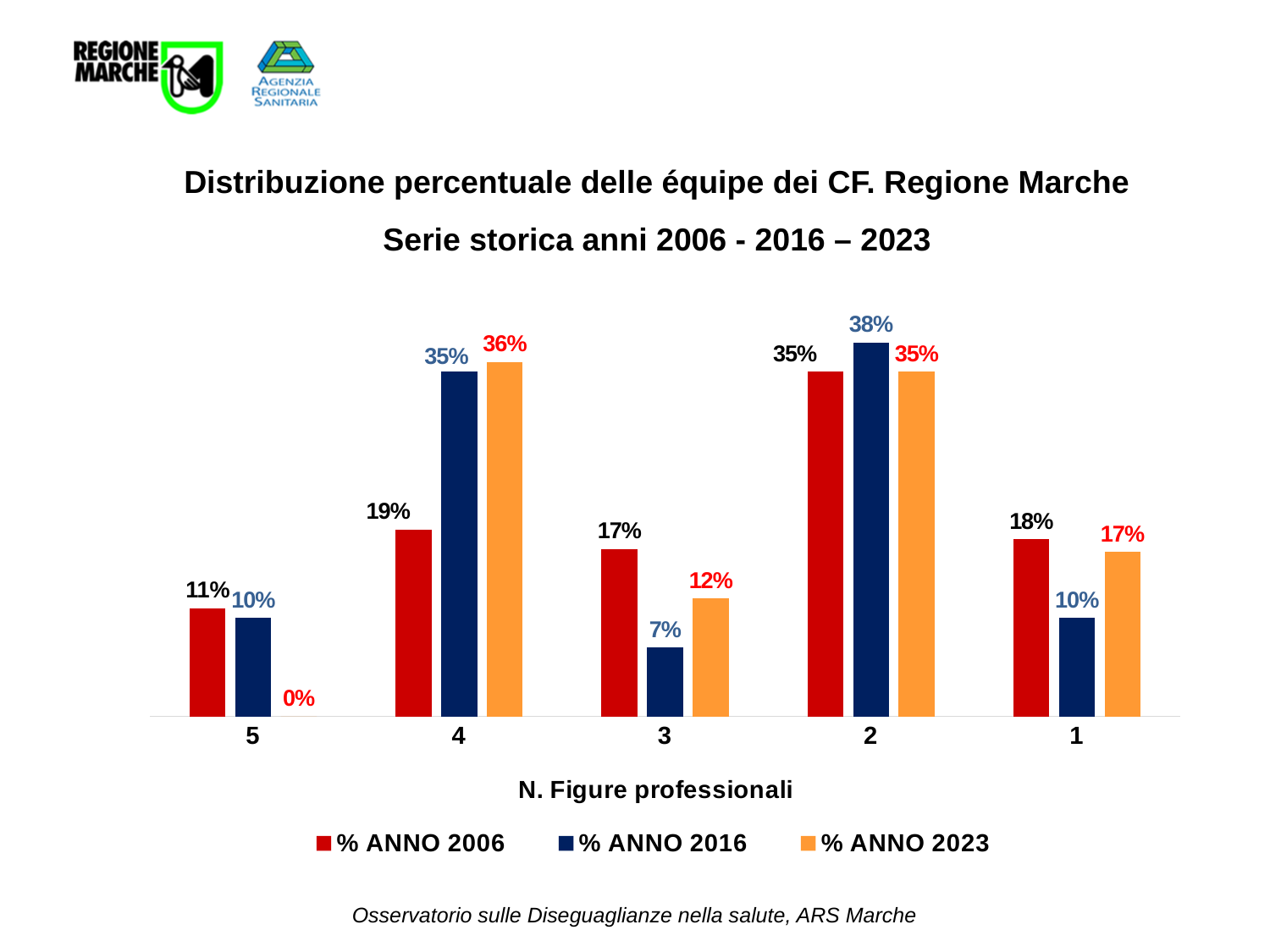
What is the value for % ANNO 2023 at 5 figure professionali? 0% What kind of chart is shown on the slide? Bar chart What is the x-axis title of the chart? N. Figure professionali What is the value for % ANNO 2016 at 3 figure professionali? 7% Which category has the lowest value for % ANNO 2006? 5 What is the value for % ANNO 2006 at 2 figure professionali? 35% Which is larger at 1 figura professionale: % ANNO 2006 or % ANNO 2016? % ANNO 2006 How many series does the legend list? 3 Which category has the highest value for % ANNO 2016? 2 How many categories are shown on the x axis? 5 What is the difference between % ANNO 2023 and % ANNO 2006 at 4 figure professionali? 17% What is the value for % ANNO 2023 at 4 figure professionali? 36%